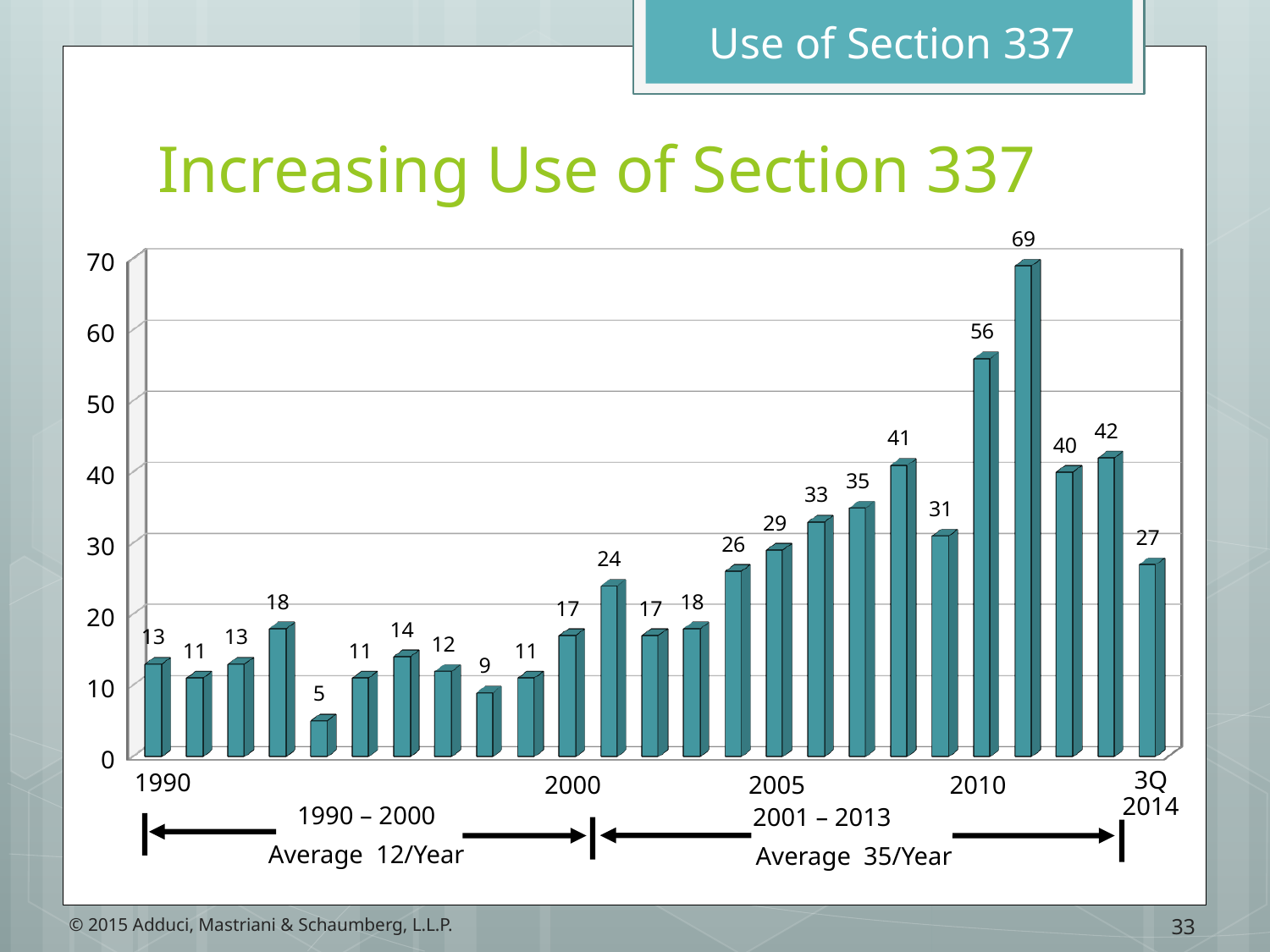
What is the average per year stated for 2001 – 2013? 35/Year What kind of chart is shown? Bar chart What is the value for 2005? 29 How many bars are plotted on the chart? 25 What is the value for 3Q 2014? 27 What is the difference between the values for 2010 and 1990? 43 What is the value for 2000? 17 Which is larger, the value for 2005 or the value for 2000? 2005 What is the value for 1990? 13 What is the value for 2010? 56 What is the lowest value shown on the chart? 5 What is the highest value shown on the chart? 69